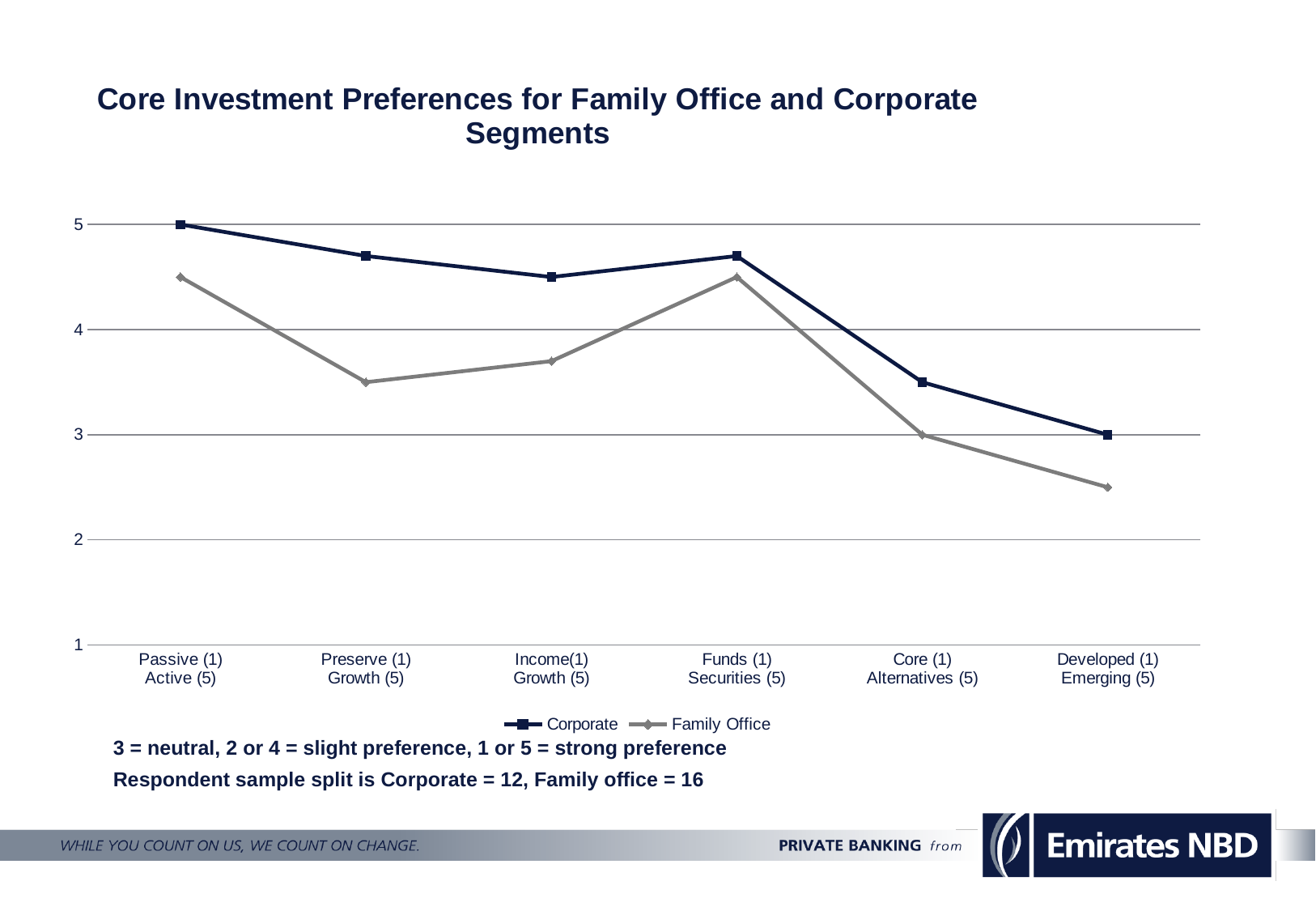
Is the Family Office value for Preserve (1) / Growth (5) greater or less than 4? less Is the Family Office value for Developed (1) / Emerging (5) greater or less than 3? less Which category has the lowest Family Office value? Developed (1) / Emerging (5) What is the Corporate value for Developed (1) / Emerging (5)? 3 Which series is drawn in the dark navy line with square markers? Corporate How many series does the legend list? 2 How many categories are shown on the x axis? 6 What kind of chart is shown on the slide? line chart What is the Family Office value for Core (1) / Alternatives (5)? 3 What is the Corporate value for Passive (1) / Active (5)? 5 For Preserve (1) / Growth (5), which series has the larger value, Corporate or Family Office? Corporate Which category has the highest Corporate value? Passive (1) / Active (5)